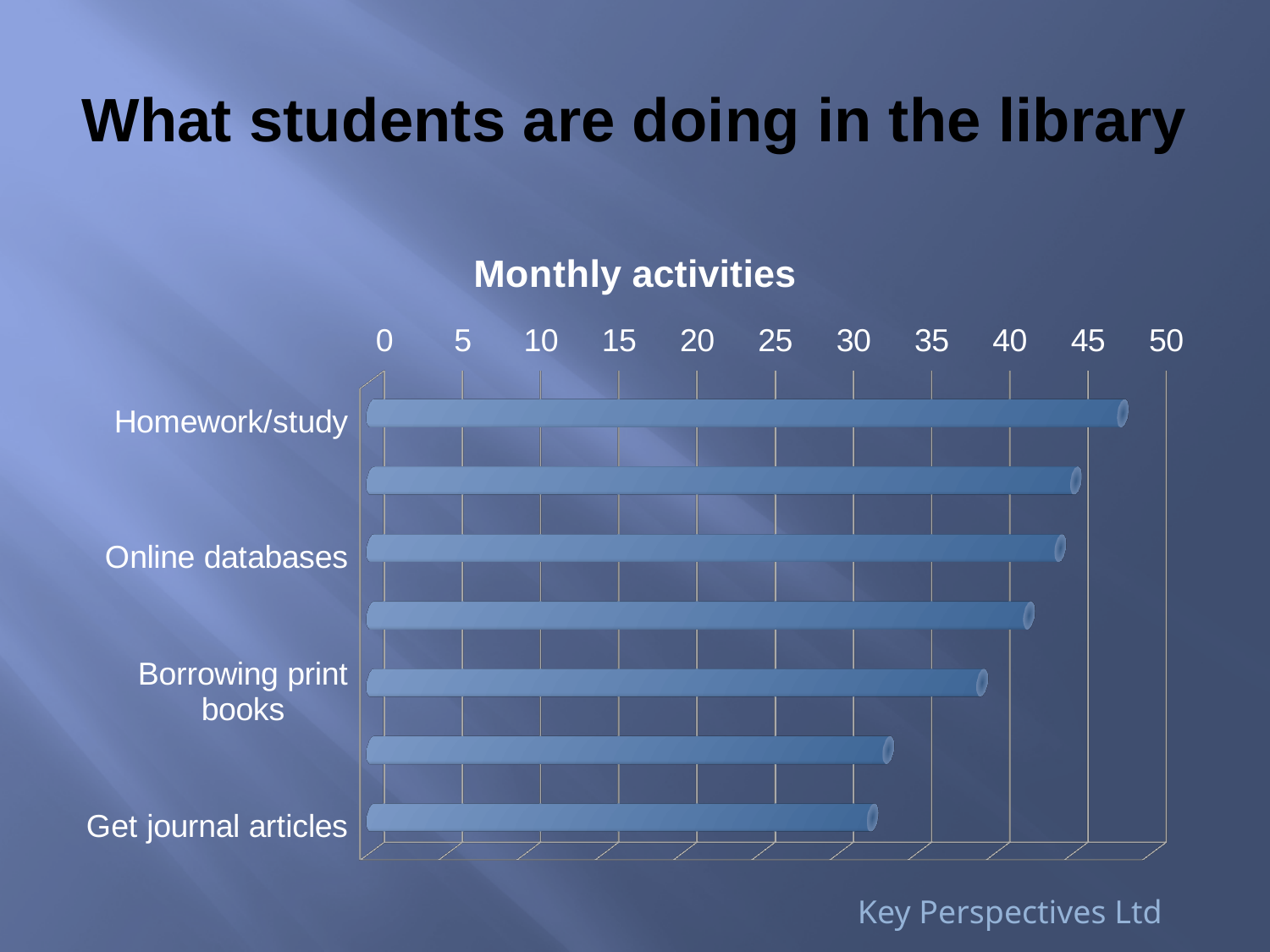
Which is larger, the value for Online databases or the value for Borrowing print books? Online databases Which activity has the shortest bar? Get journal articles Do the bar lengths increase or decrease going from the top of the chart to the bottom? decrease Is the value for Online databases greater or less than 40? greater Which activity has the longest bar? Homework/study Which is larger, the value for Homework/study or the value for Get journal articles? Homework/study Is the value for Get journal articles greater or less than 35? less How many bars are plotted in the chart? 7 What type of chart is shown on the slide? Bar chart Is the value for Borrowing print books greater or less than 40? less What is the title of the chart? Monthly activities